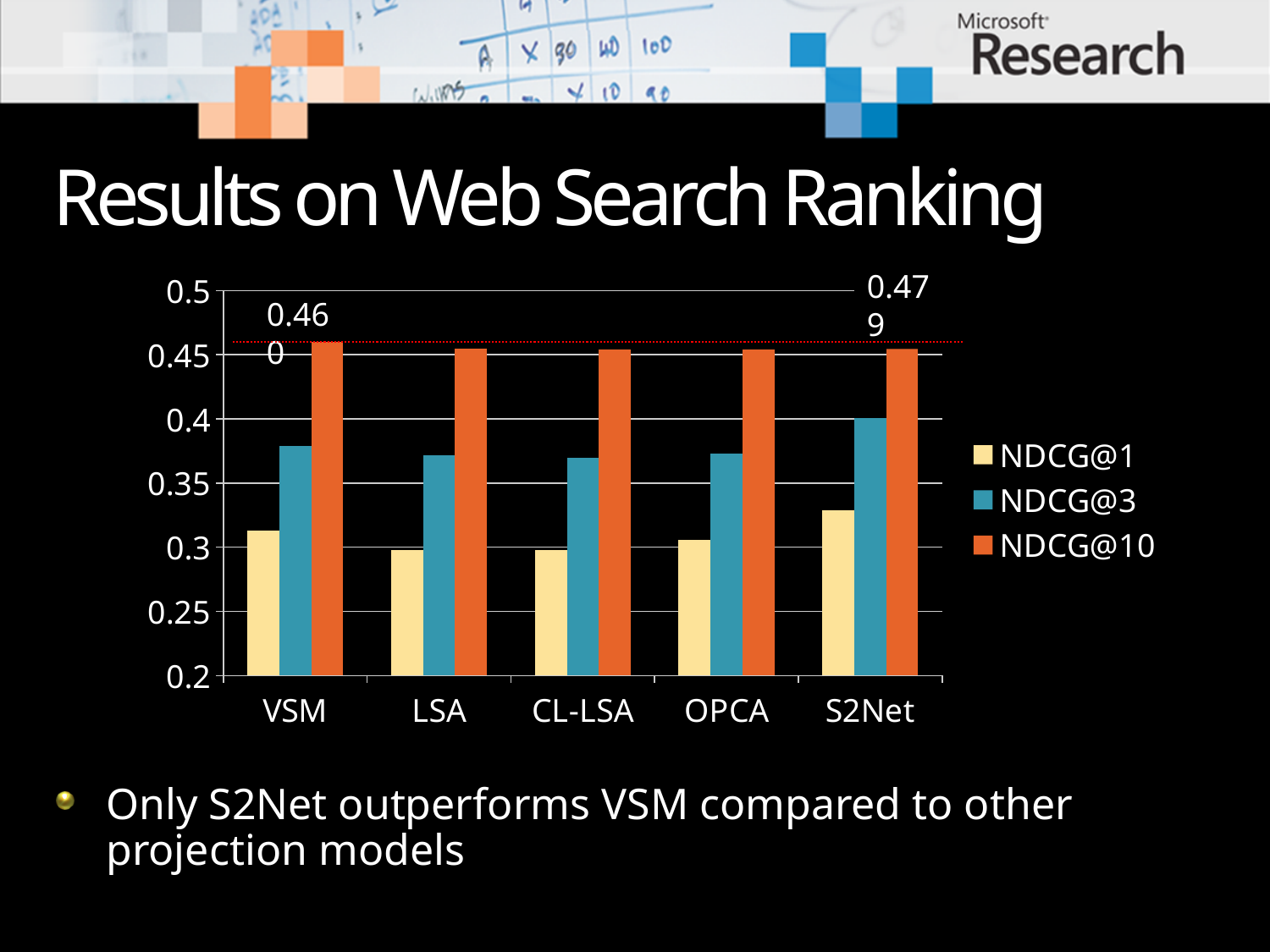
Which model has the highest NDCG@3 value? S2Net Is the NDCG@10 value for LSA greater or less than 0.4? greater Which model has the highest NDCG@1 value? S2Net How many models (categories) are shown on the x axis of the chart? 5 Which series is shown in orange in the chart's legend? NDCG@10 Which is larger, the NDCG@1 value for S2Net or the NDCG@1 value for VSM? S2Net What kind of chart is shown on the slide? bar chart Is the NDCG@3 value for OPCA greater or less than 0.4? less For CL-LSA, which is larger, the NDCG@3 value or the NDCG@1 value? NDCG@3 Is the NDCG@3 value for VSM greater or less than 0.4? less How many series does the chart's legend list? 3